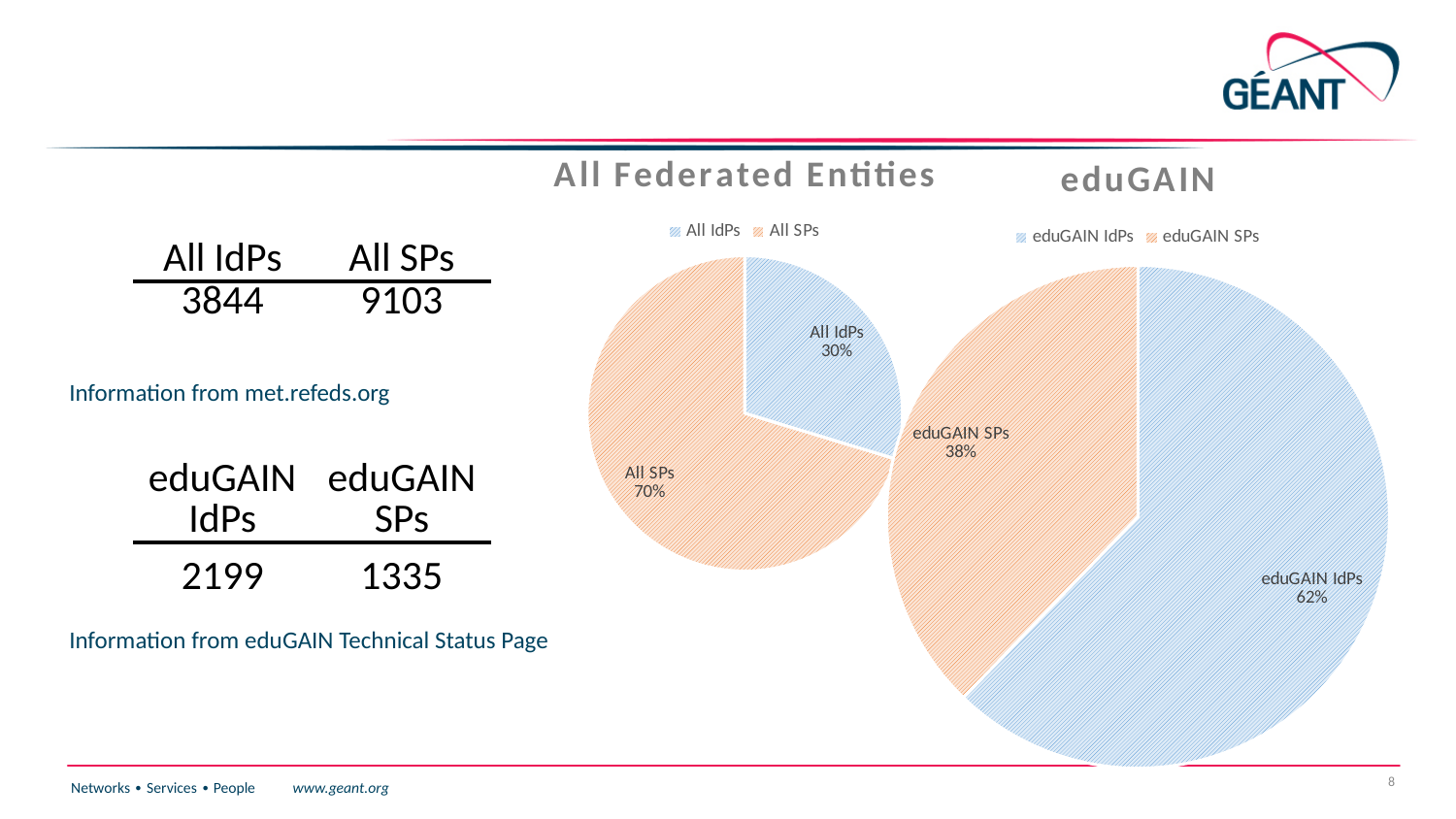
In the 'All Federated Entities' pie chart, what percentage is shown for All IdPs? 30% In the 'All Federated Entities' pie chart, what is the difference in percentage points between All SPs and All IdPs? 40 In the 'eduGAIN' pie chart, what percentage is shown for eduGAIN SPs? 38% In the 'All Federated Entities' pie chart, what percentage is shown for All SPs? 70% How many entries does the legend of the 'All Federated Entities' chart list? 2 In the 'All Federated Entities' pie chart, which slice is the largest? All SPs In the 'eduGAIN' pie chart, what is the difference in percentage points between eduGAIN IdPs and eduGAIN SPs? 24 What type of chart is used for 'All Federated Entities'? Pie chart How many slices does the 'eduGAIN' pie chart have? 2 In the 'eduGAIN' pie chart, which slice is the smallest? eduGAIN SPs In the 'eduGAIN' pie chart, what percentage is shown for eduGAIN IdPs? 62% In the 'eduGAIN' pie chart, which is larger: eduGAIN IdPs or eduGAIN SPs? eduGAIN IdPs